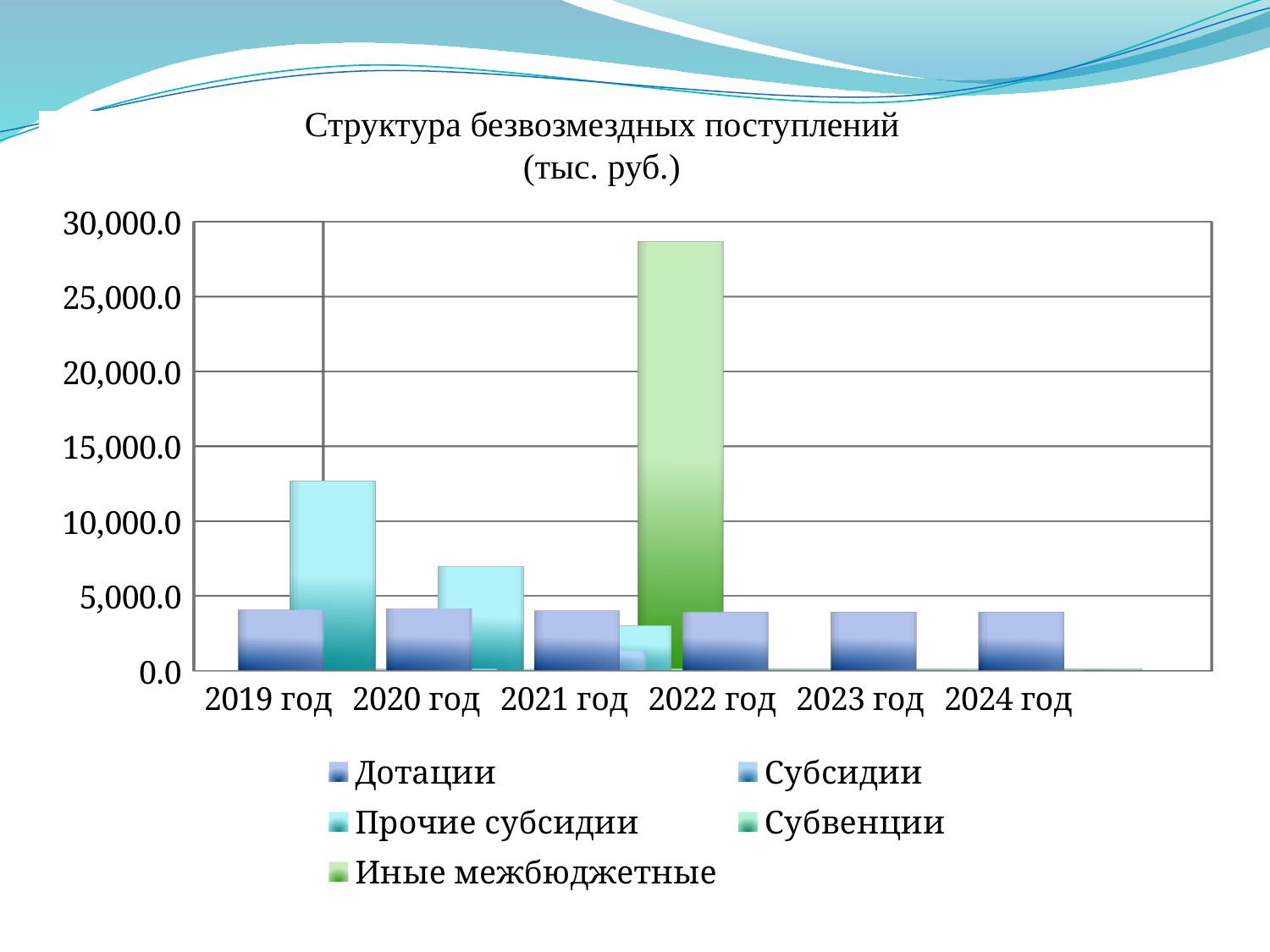
What is the title of the chart? Структура безвозмездных поступлений (тыс. руб.) Is the value for Дотации in 2019 год greater or less than 5,000.0? less Which is larger, Прочие субсидии in 2019 год or Прочие субсидии in 2020 год? 2019 год Which series has the tallest bar in the chart? Иные межбюджетные What is the highest value shown on the y axis? 30,000.0 Is the value for Прочие субсидии in 2020 год greater or less than 5,000.0? greater How many year categories are shown on the x axis? 6 How many series does the legend list? 5 Is the value for Прочие субсидии in 2019 год greater or less than 10,000.0? greater Which year has the tallest bar in the chart? 2021 год What kind of chart is shown on the slide? bar chart